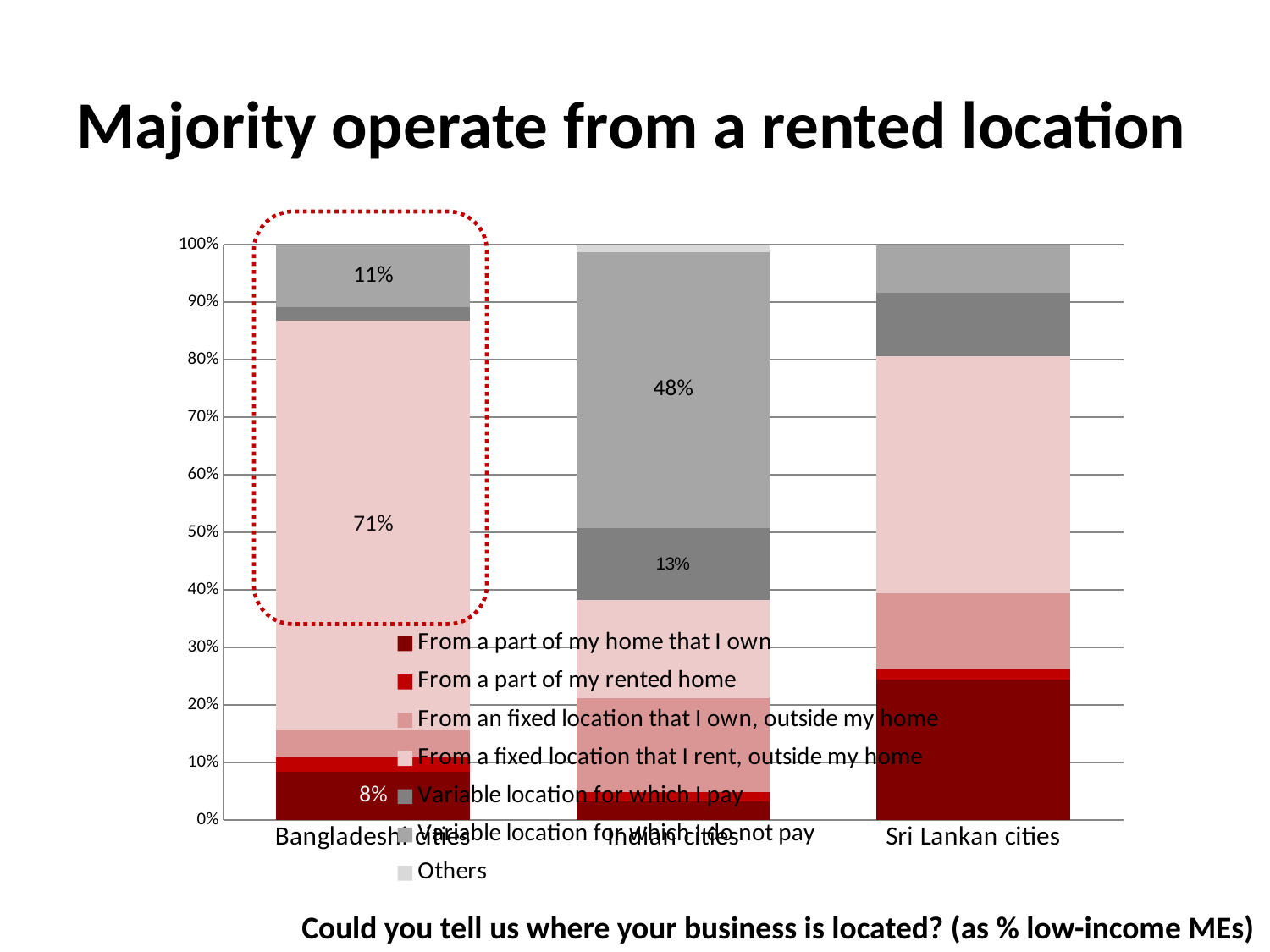
What is the title of the slide containing the chart? Majority operate from a rented location In Indian cities, what percentage operate from a variable location for which they do not pay? 48% In Indian cities, what percentage operate from a variable location for which they pay? 13% In Indian cities, what is the difference in percentage points between the 'Variable location for which I do not pay' segment (48%) and the 'Variable location for which I pay' segment (13%)? 35 percentage points What kind of chart is shown on the slide? Stacked bar chart What is the data label for 'From a part of my home that I own' in the Bangladesh cities bar? 8% In Bangladesh cities, what percentage of low-income MEs operate from a fixed location that they rent, outside their home? 71% In Bangladesh cities, what percentage operate from a variable location for which they do not pay? 11% Which city group has the largest share for 'From a fixed location that I rent, outside my home'? Bangladesh cities How many series does the chart's legend list? 7 How many city groups are shown on the x axis of the chart? 3 Is the share for 'From a part of my home that I own' in Sri Lankan cities greater or less than 20%? greater